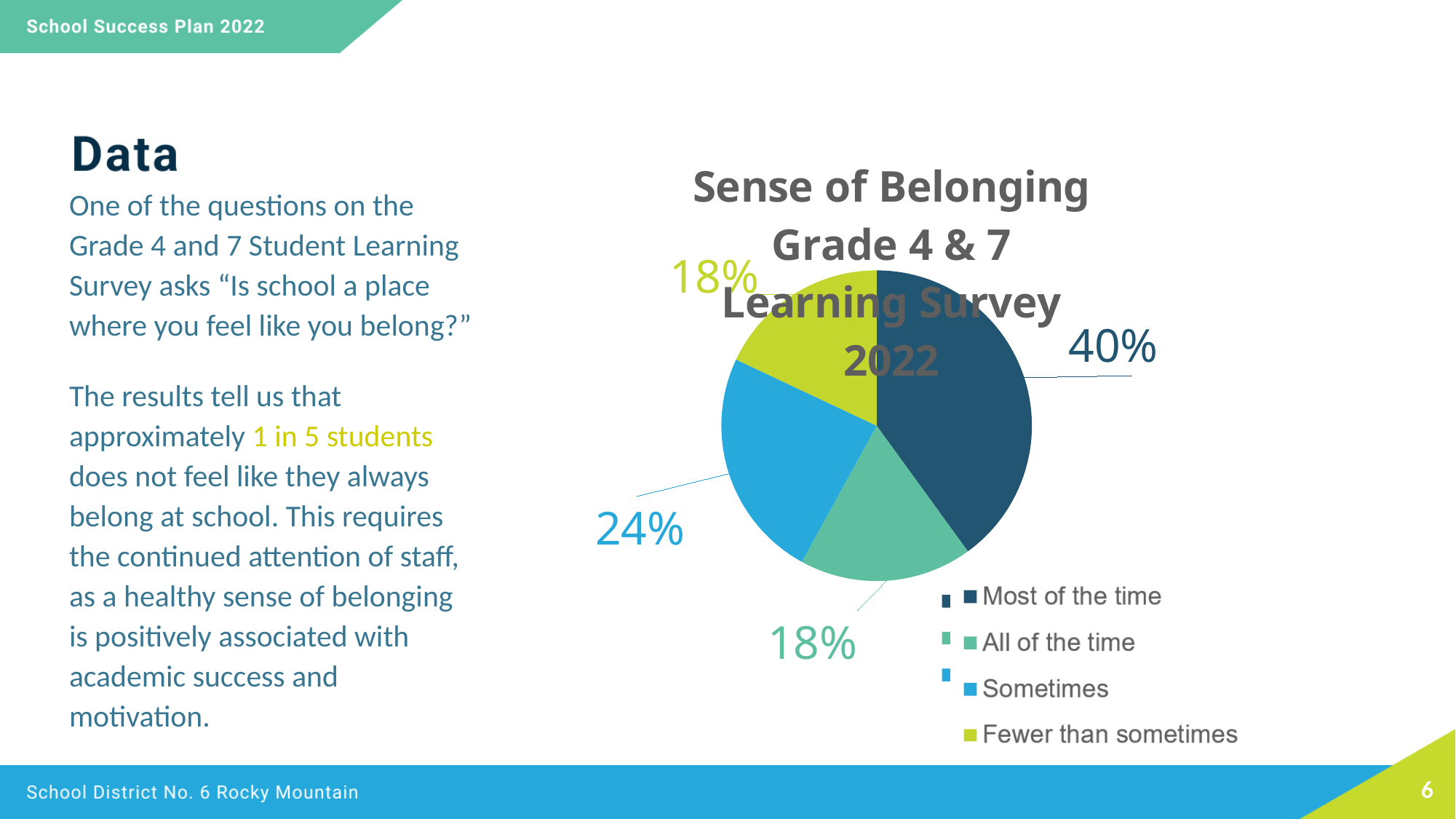
What kind of chart is shown on the slide? pie chart What percentage of students answered "Most of the time"? 40% What percentage of students answered "Sometimes"? 24% How many categories does the legend list? 4 What is the difference in percentage points between "Most of the time" and "Sometimes"? 16 Which colour represents "Fewer than sometimes" in the chart? yellow-green What percentage of students answered "Fewer than sometimes"? 18% What is the combined percentage for "Most of the time" and "All of the time"? 58% Which response category has the largest share of the pie? Most of the time Which is larger, the share for "Sometimes" or the share for "All of the time"? Sometimes What percentage of students answered "All of the time"? 18% What is the title of the chart? Sense of Belonging Grade 4 & 7 Learning Survey 2022